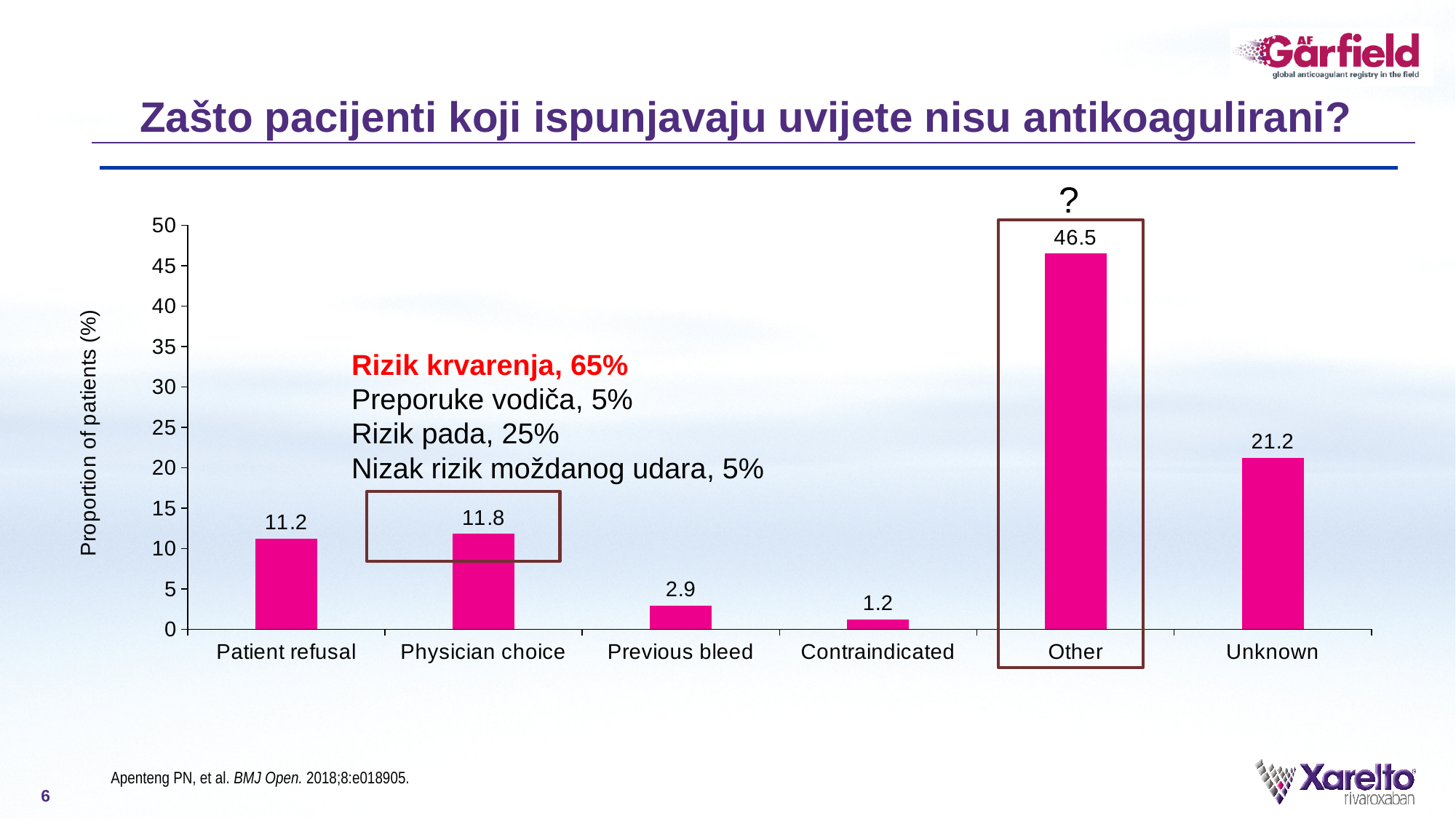
What is the value for Unknown? 21.2 How many categories are shown on the x axis? 6 What is the value for Patient refusal? 11.2 What is the value for Contraindicated? 1.2 What is the difference between the values for Physician choice and Patient refusal? 0.6 What is the label of the y axis? Proportion of patients (%) Which category has the lowest value? Contraindicated What kind of chart is shown on the slide? Bar chart Which category has the highest value? Other What is the difference between the values for Other and Unknown? 25.3 Which is larger, the value for Previous bleed or the value for Contraindicated? Previous bleed What is the value for Other? 46.5